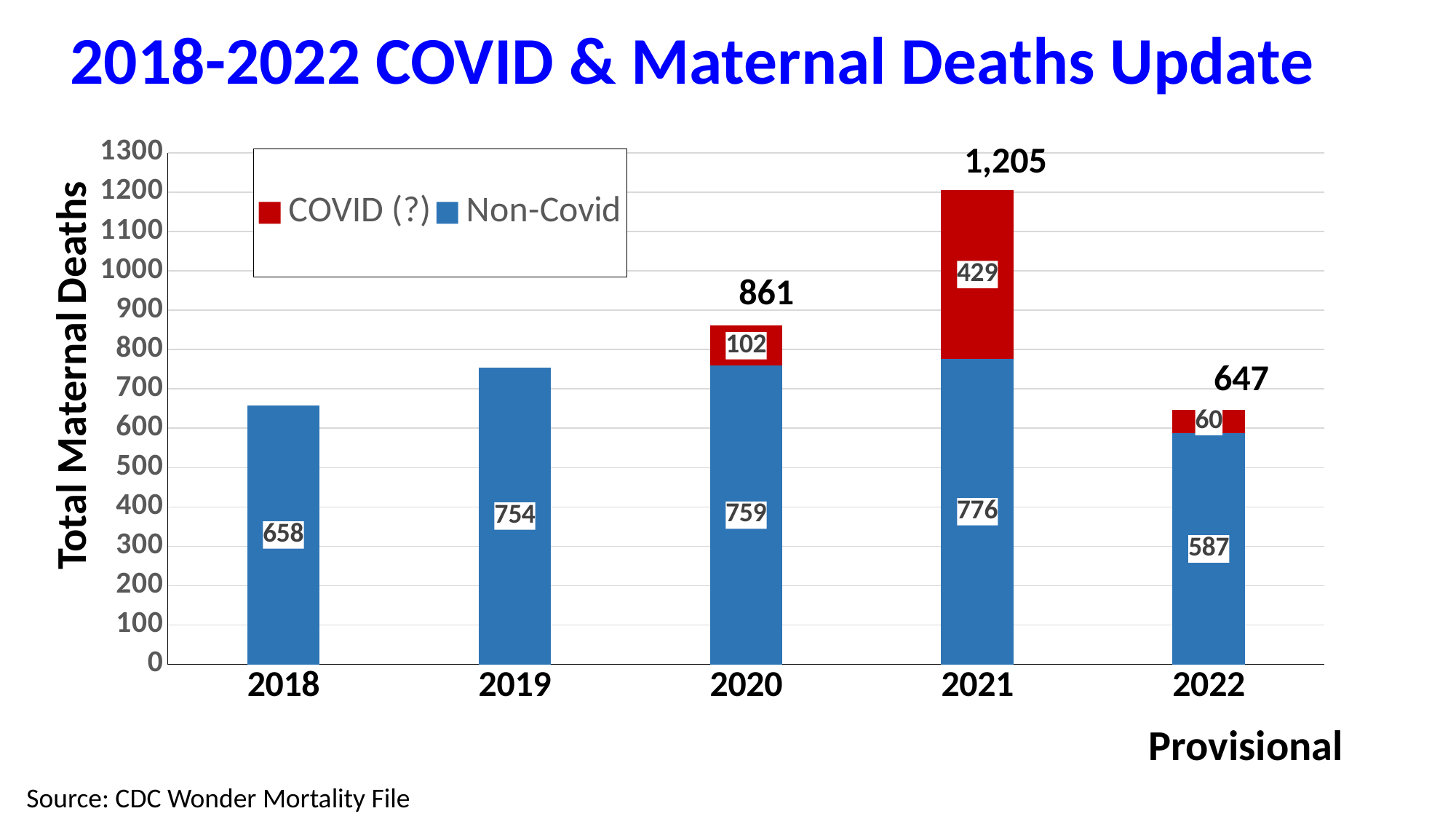
How many years are shown on the x axis? 5 What is the total of the stacked bar for 2020? 861 What is the COVID (?) value for 2021? 429 What kind of chart is shown on the slide? Stacked bar chart Which year has the lowest Non-Covid value? 2022 What is the Non-Covid value for 2018? 658 Which year has the highest Non-Covid value? 2021 How many series does the legend list? 2 What is the difference between the COVID (?) values for 2021 and 2020? 327 Which is larger, the Non-Covid value for 2019 or for 2020? 2020 What is the Non-Covid value for 2022? 587 What is the total of the stacked bar for 2021? 1,205